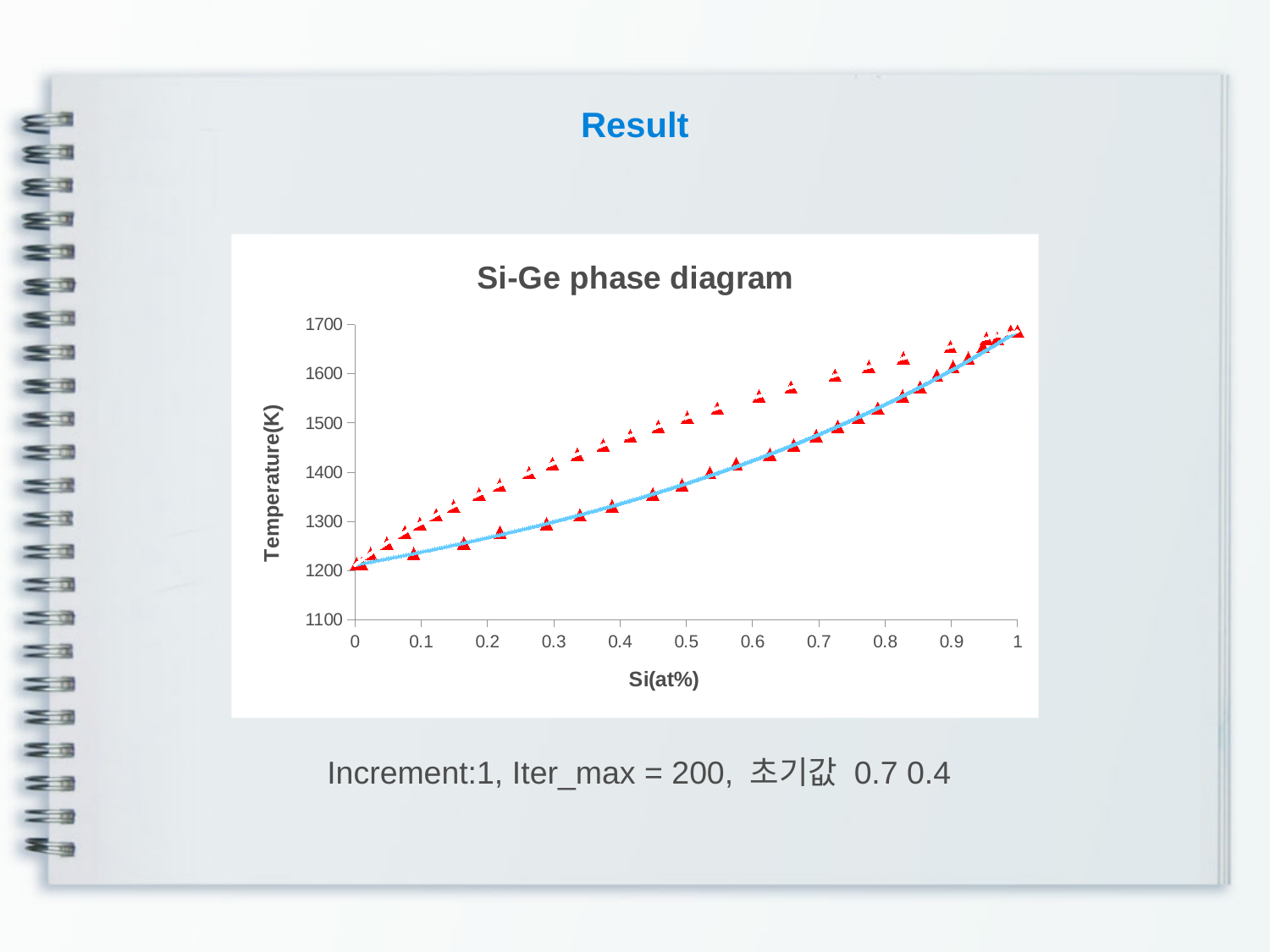
What is the lowest value shown on the Temperature(K) axis? 1100 Is the temperature of the lower curve at Si(at%) = 0.5 greater or less than 1400? less Is the temperature of the lower curve at Si(at%) = 0.7 greater or less than 1500? less Do the plotted temperatures rise or fall as Si(at%) increases from 0 to 1? rise What is the label of the vertical axis? Temperature(K) Is the temperature of the upper red-triangle curve at Si(at%) = 0.3 greater or less than 1400? greater What is the title of the chart? Si-Ge phase diagram What is the highest value shown on the Temperature(K) axis? 1700 What type of chart is the Si-Ge phase diagram? scatter chart How many tick labels are shown on the Si(at%) axis? 11